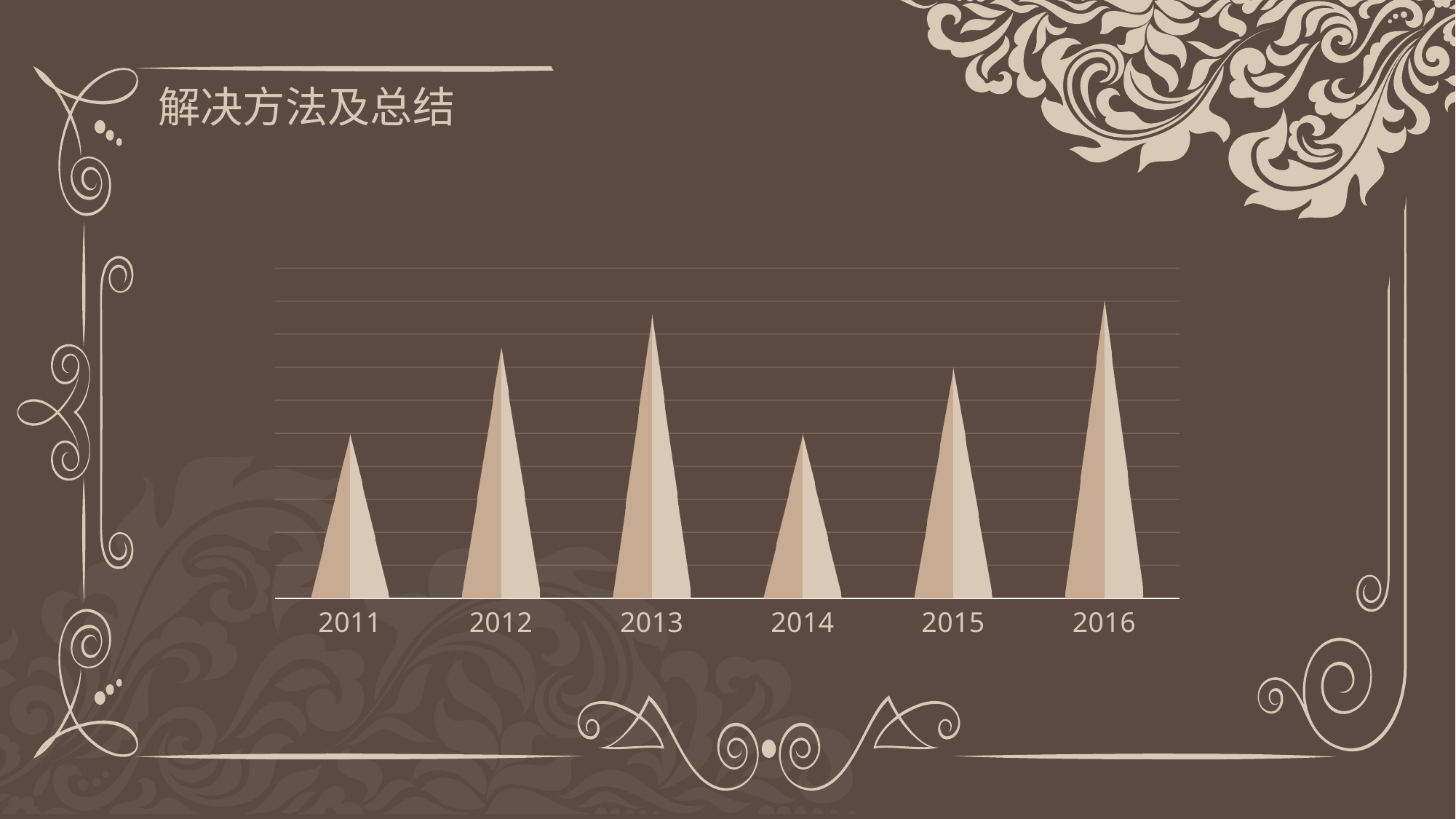
Which year has the highest bar in the chart? 2016 Which is larger, the value for 2013 or the value for 2014? 2013 Which is larger, the value for 2011 or the value for 2012? 2012 Which is larger, the value for 2012 or the value for 2014? 2012 What kind of chart is shown on the slide? bar chart What is the first year shown on the x axis of the chart? 2011 Do the values rise or fall from 2013 to 2014? fall How many categories (years) are shown on the x axis of the chart? 6 Do the values rise or fall from 2014 to 2016? rise What is the title of the slide containing the chart? 解决方法及总结